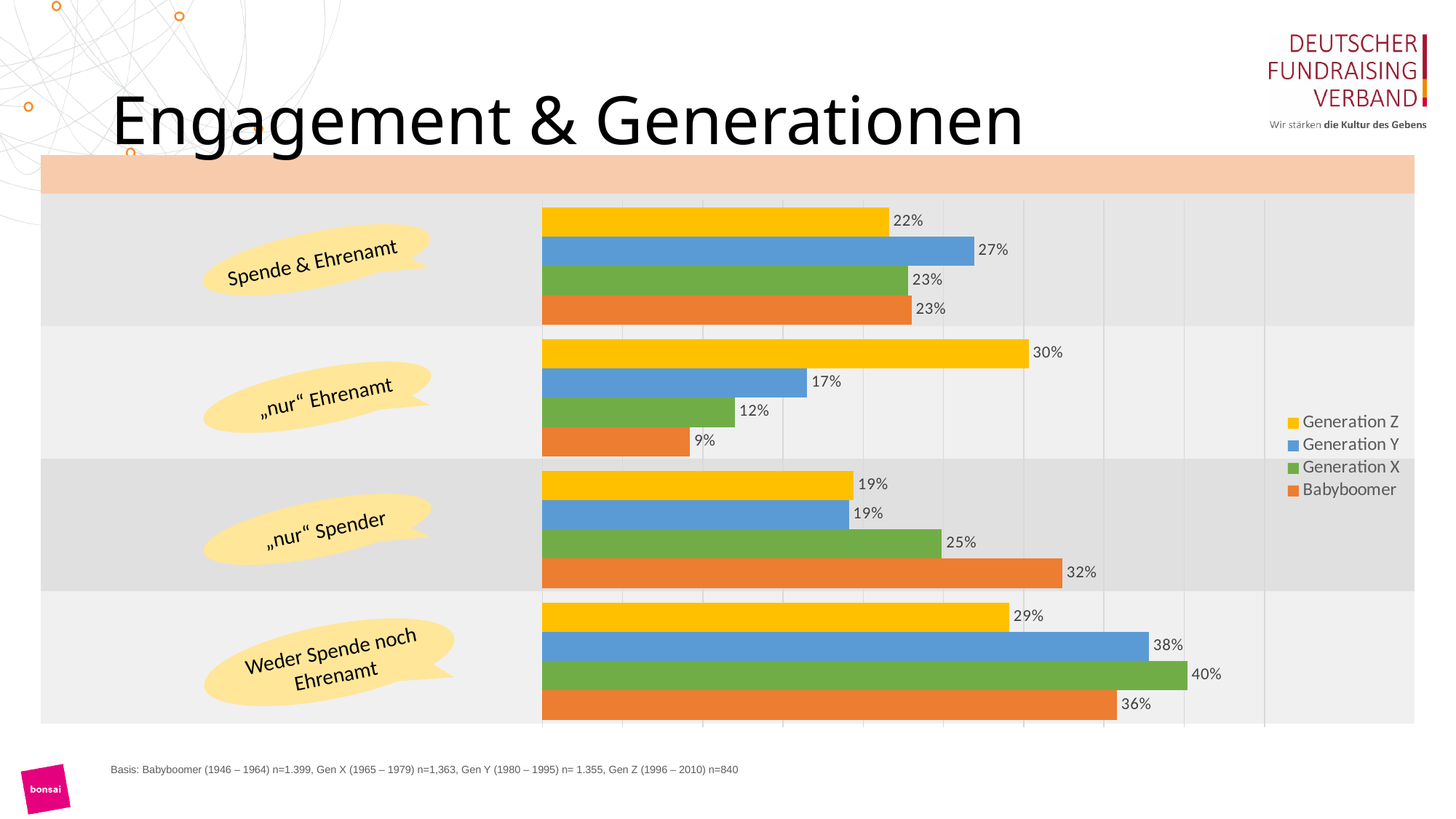
Which generation has the highest value in the "Spende & Ehrenamt" category? Generation Y How many series does the legend list? 4 What kind of chart is shown on the slide? Bar chart Which colour represents Generation Z in the chart? Yellow What is the difference between Generation Z and Babyboomer in the "„nur“ Ehrenamt" category? 21 percentage points Which generation has the lowest value in the "„nur“ Ehrenamt" category? Babyboomer How many categories are shown on the chart? 4 What is the value for Generation X in the "Weder Spende noch Ehrenamt" category? 40% What is the value for Generation Y in the "Spende & Ehrenamt" category? 27% What is the value for Babyboomer in the "„nur“ Ehrenamt" category? 9% Which is larger in the "Weder Spende noch Ehrenamt" category: Generation Y or Babyboomer? Generation Y Which generation has the highest value in the "„nur“ Spender" category? Babyboomer